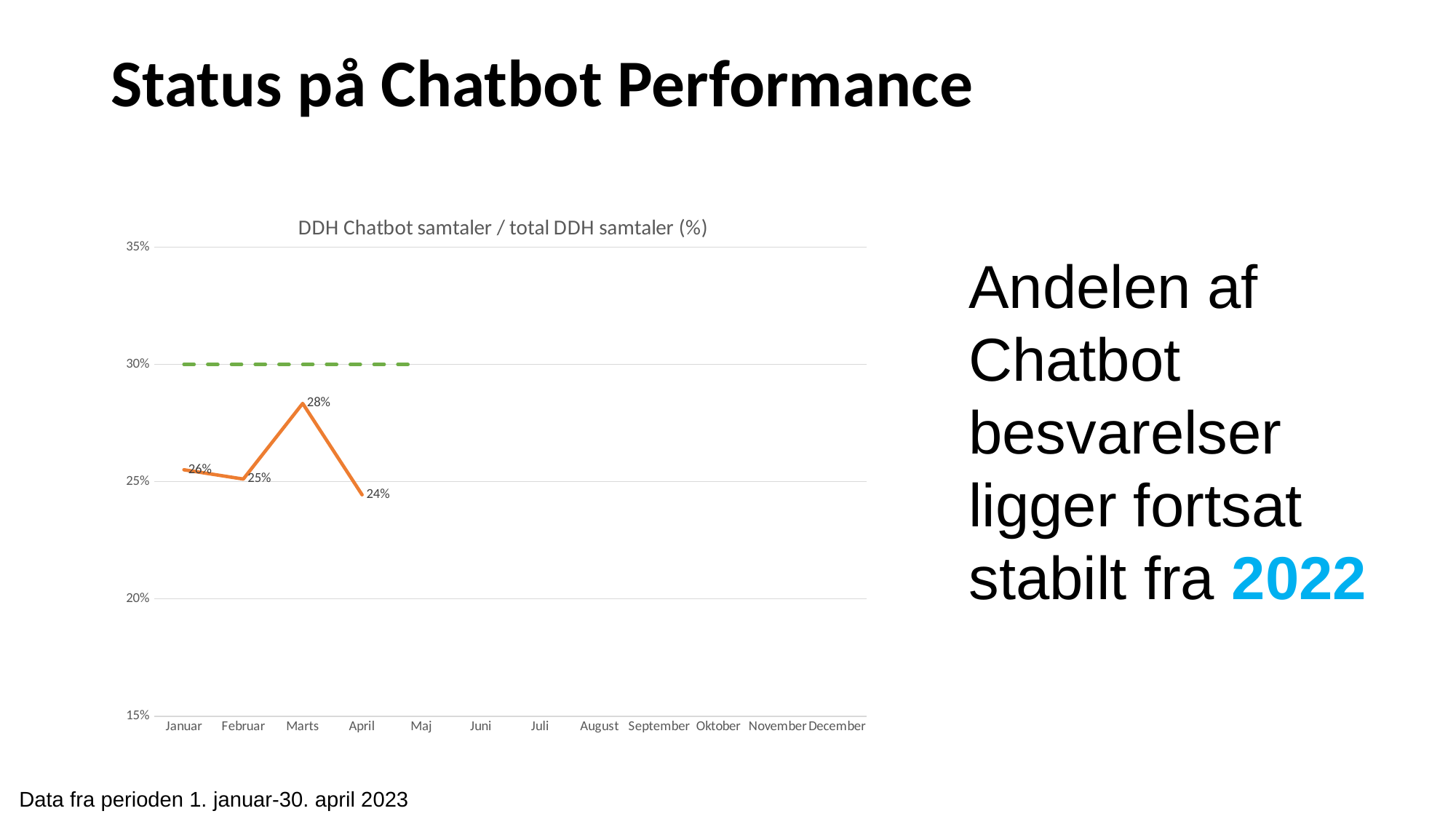
Which is larger, the value for Januar or the value for Februar? Januar Which month has the lowest plotted value? April Which month has the highest plotted value? Marts How many months are labelled on the x axis? 12 What is the value for April in the chart? 24% Is the value for Marts greater or less than 30%? less What is the value for Januar in the chart? 26% What kind of chart is shown on the slide? line chart What is the value for Februar in the chart? 25% What is the difference between the values for Marts and April? 4% What is the title of the chart? DDH Chatbot samtaler / total DDH samtaler (%) What is the value for Marts in the chart? 28%